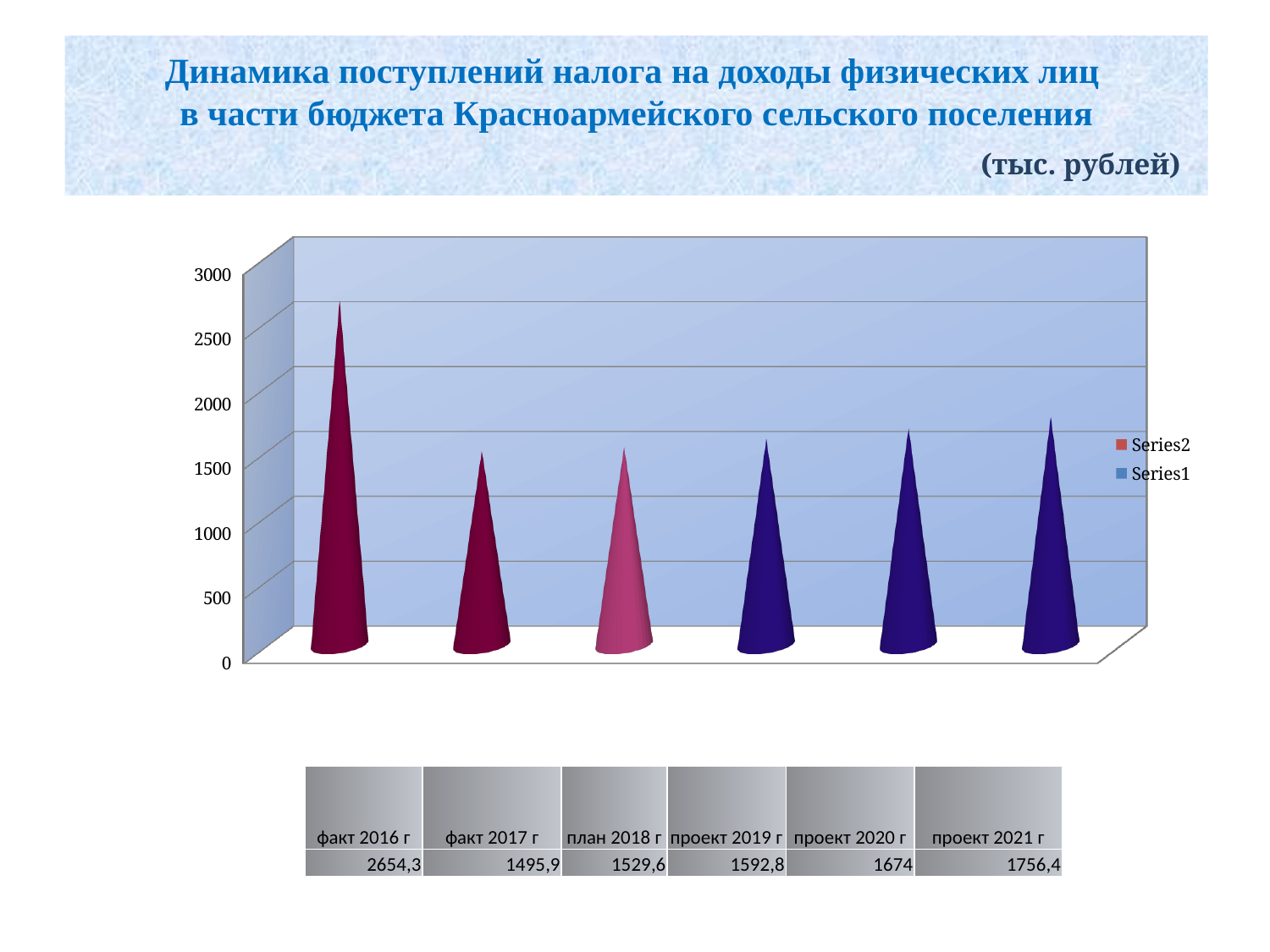
What is the difference between the values for проект 2021 г and проект 2020 г? 82,4 Which category has the lowest value? факт 2017 г Which category has the highest value? факт 2016 г Which is larger, the value for проект 2019 г or the value for план 2018 г? проект 2019 г What is the value for факт 2016 г? 2654,3 What is the difference between the values for факт 2016 г and факт 2017 г? 1158,4 Is the value for факт 2016 г greater or less than 2500? greater What is the value for план 2018 г? 1529,6 Do the values rise or fall from факт 2017 г to проект 2021 г? rise How many series does the legend list? 2 What is the value for проект 2020 г? 1674 How many categories are shown on the chart? 6